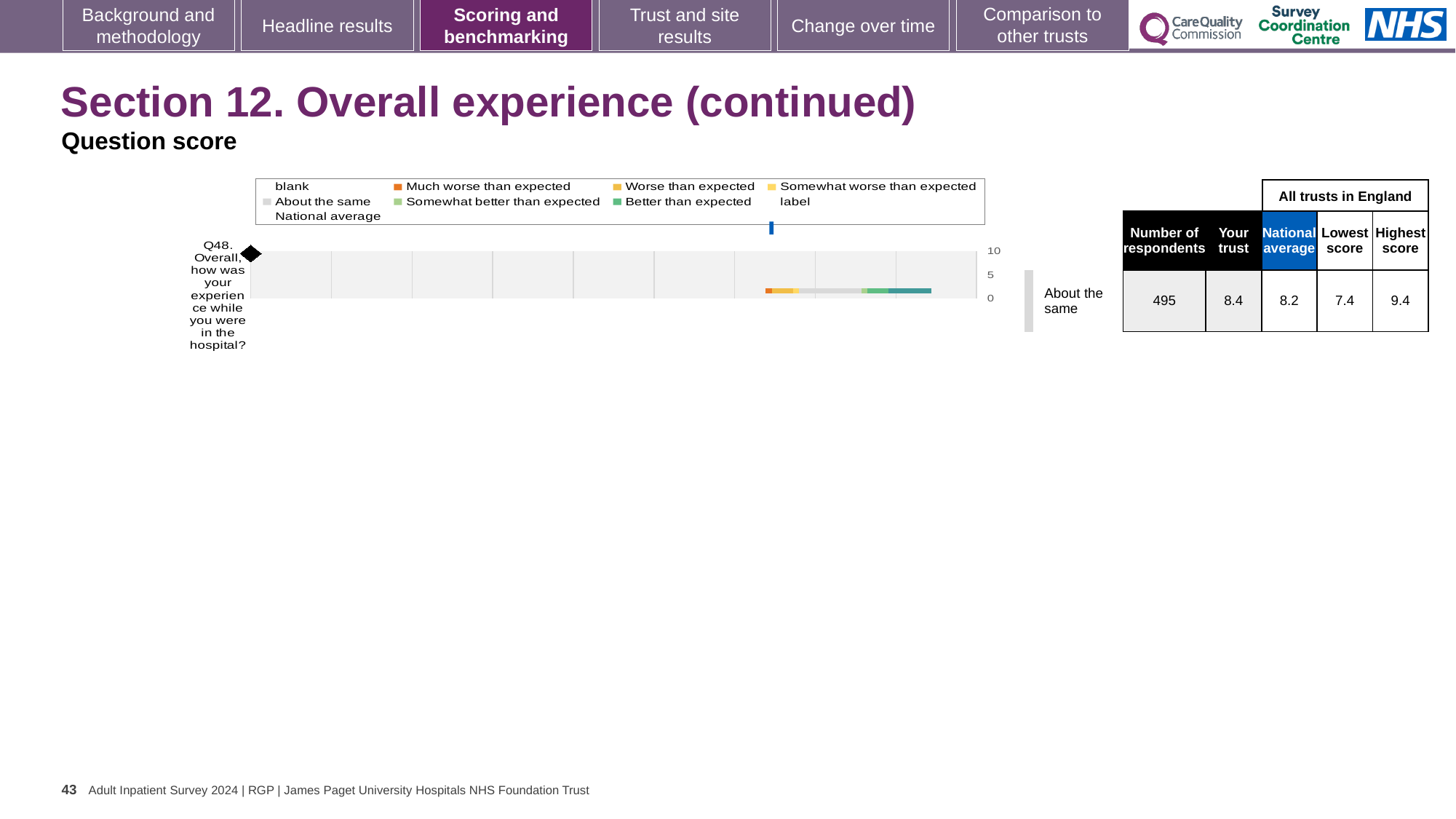
According to the table beside the chart, how many respondents answered Q48? 495 According to the table beside the chart, what is the national average score for Q48? 8.2 How many survey questions are plotted on the chart? 1 What benchmark category is shown for Q48 next to the chart? About the same What is the lowest score among all trusts in England for Q48? 7.4 According to the table beside the chart, what is the 'Your trust' score for Q48? 8.4 What is the difference between the highest score and the lowest score for Q48 in the table beside the chart? 2.0 Which question number is plotted on the chart? Q48 What is the highest tick value shown on the chart's score axis? 10 What kind of chart is shown on the slide? bar chart Which is larger for Q48, the 'Your trust' score or the national average? Your trust What is the difference between the 'Your trust' score and the national average for Q48? 0.2